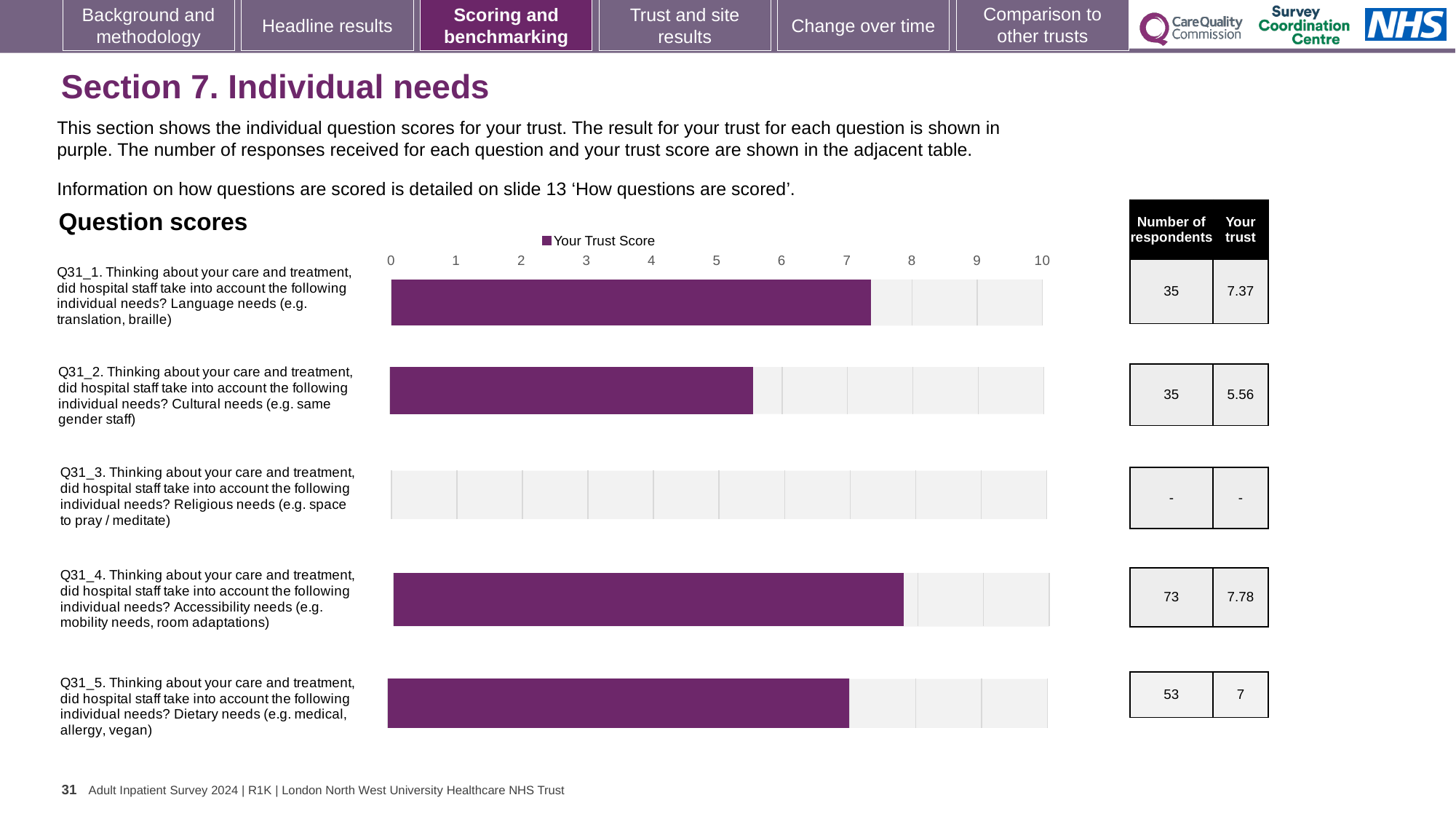
Among the questions with a plotted score, which has the lowest trust score? Q31_2 (Cultural needs) What is the trust score for Q31_5 (Dietary needs)? 7 What is the trust score for Q31_2 (Cultural needs)? 5.56 Which has a higher trust score, Q31_1 (Language needs) or Q31_5 (Dietary needs)? Q31_1 (Language needs) Which question has the highest trust score? Q31_4 (Accessibility needs) How many questions are listed in the chart? 5 Is the trust score for Q31_2 (Cultural needs) greater or less than 6? less What type of chart is shown? Bar chart How many respondents answered Q31_4 (Accessibility needs)? 73 What is the trust score for Q31_4 (Accessibility needs)? 7.78 What is the trust score for Q31_1 (Language needs)? 7.37 What is the difference between the trust scores for Q31_4 (Accessibility needs) and Q31_2 (Cultural needs)? 2.22